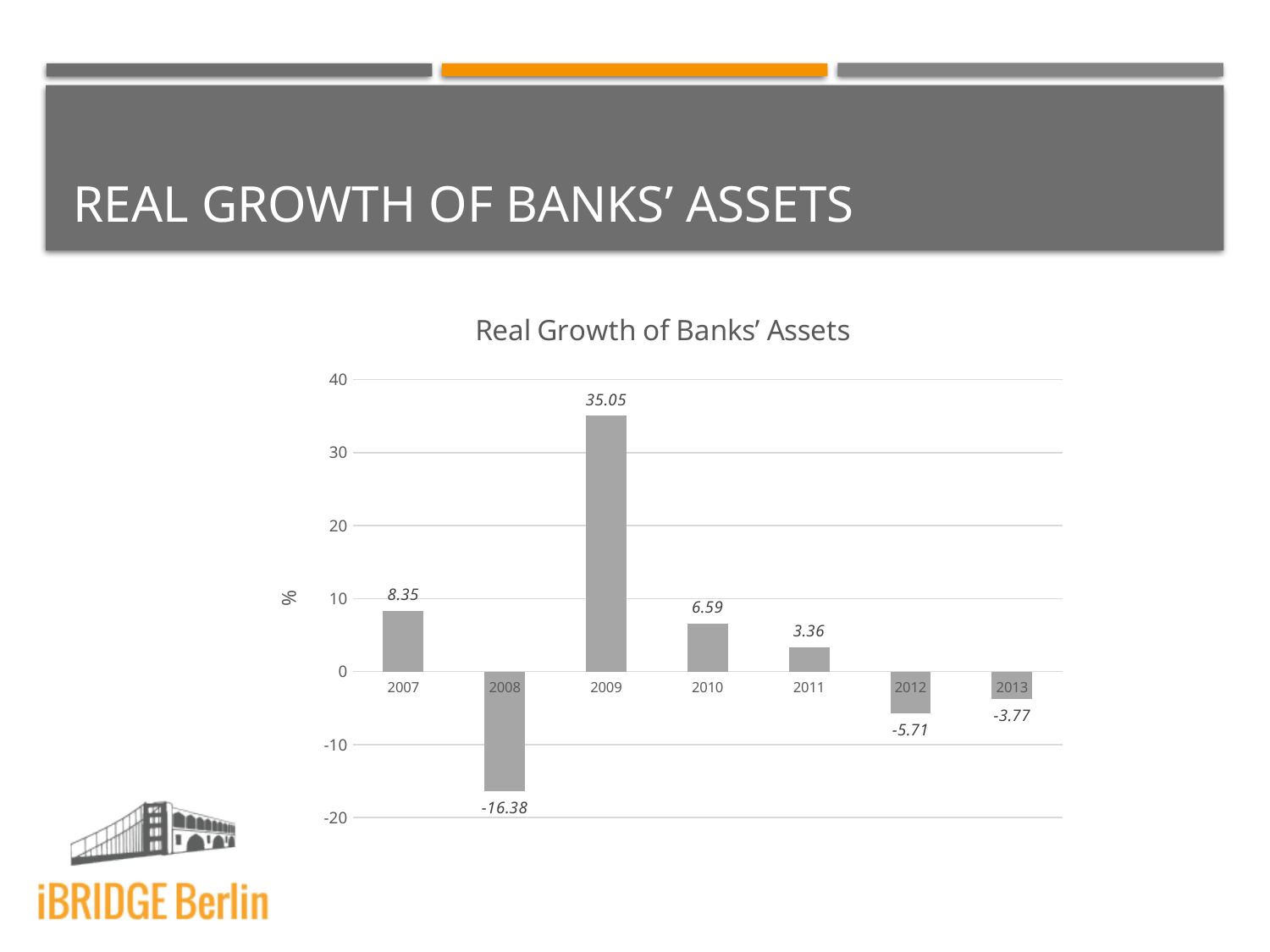
What kind of chart is shown on the slide? Bar chart Do the values rise or fall from 2009 to 2012? Fall What is the value for 2008? -16.38 Is the value for 2009 greater or less than 30? greater How many years are shown on the x axis? 7 Which is larger, the value for 2011 or the value for 2013? 2011 What is the difference between the values for 2007 and 2010? 1.76 Which year has the highest real growth of banks' assets? 2009 What is the label on the vertical axis of the chart? % Which year has the lowest real growth of banks' assets? 2008 What is the value for 2009? 35.05 What is the value for 2012? -5.71